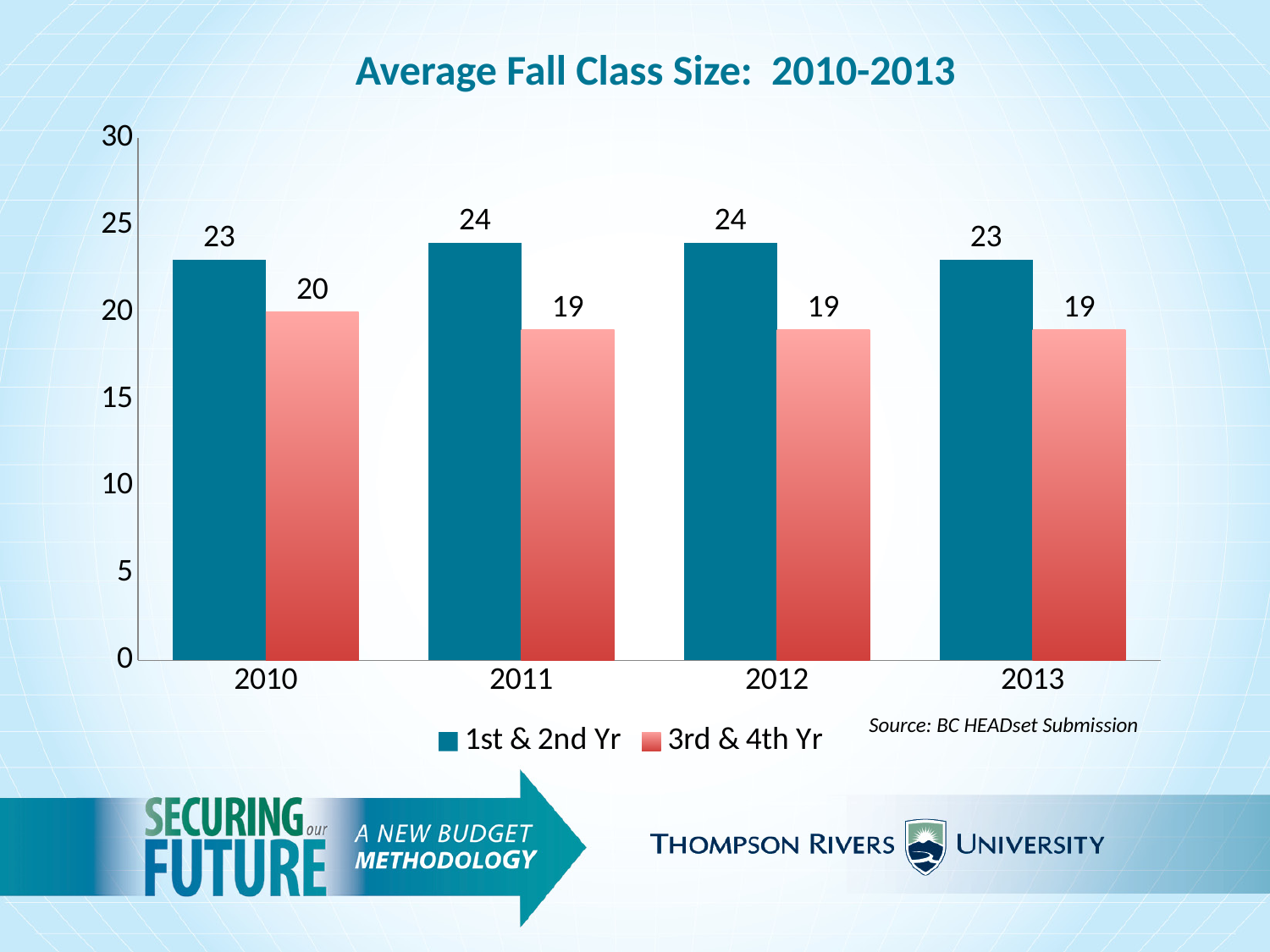
What kind of chart is shown on the slide? Bar chart Which is larger in 2010: the 1st & 2nd Yr value or the 3rd & 4th Yr value? 1st & 2nd Yr What is the difference between the 1st & 2nd Yr value in 2011 and in 2013? 1 How many series does the legend list? 2 What is the title of the chart? Average Fall Class Size: 2010-2013 What is the value for 1st & 2nd Yr in 2013? 23 What is the value for 3rd & 4th Yr in 2013? 19 How many years are shown on the x axis? 4 What is the average fall class size for 1st & 2nd Yr in 2011? 24 Which year has the highest value for 3rd & 4th Yr? 2010 What is the average fall class size for 3rd & 4th Yr in 2010? 20 What is the difference between the 1st & 2nd Yr and 3rd & 4th Yr values in 2012? 5